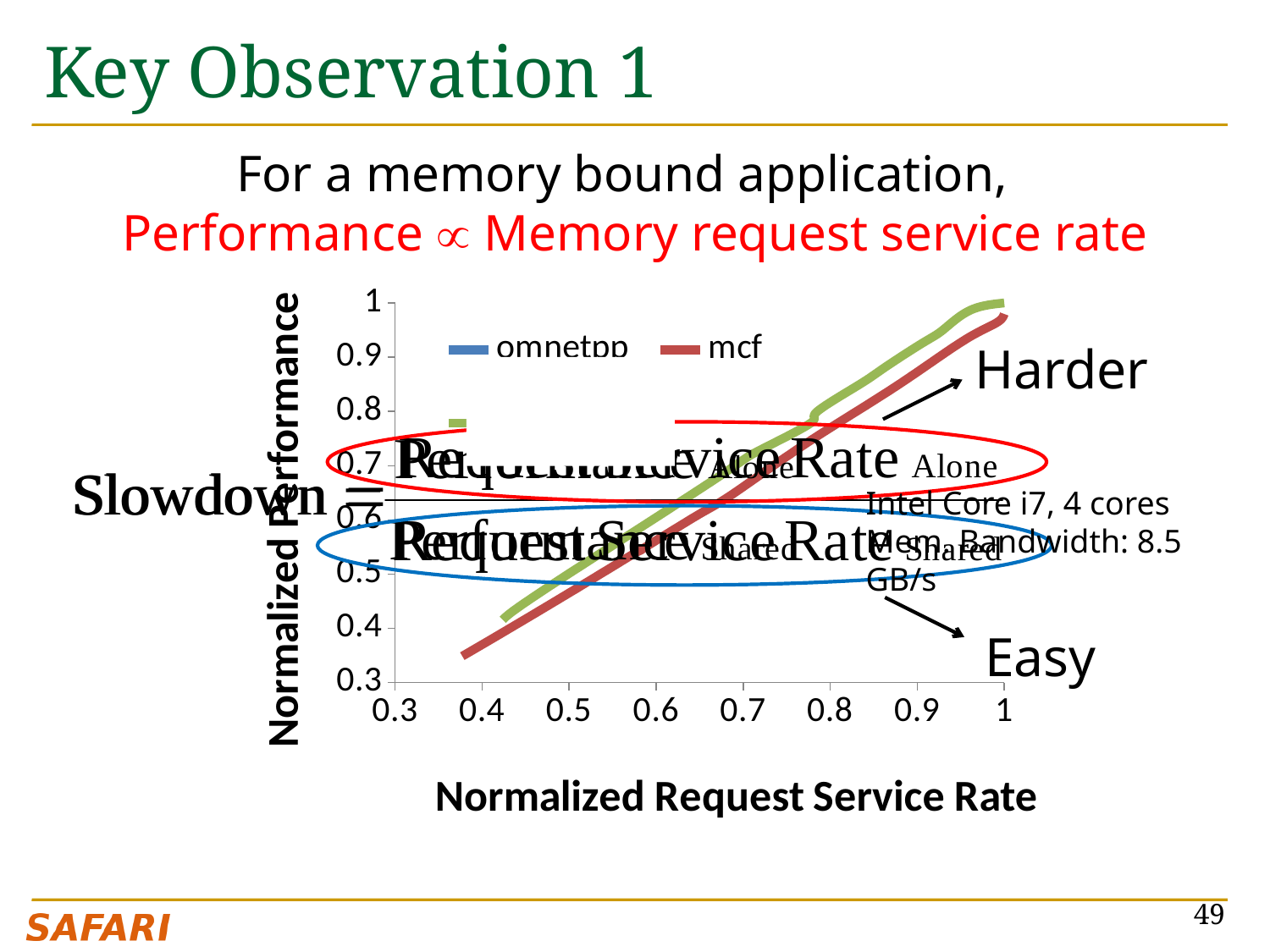
What kind of chart is shown on the slide? line chart What is the title of the chart's x axis? Normalized Request Service Rate What is the lowest value shown on the chart's y axis? 0.3 How many tick labels are shown on the chart's x axis? 8 Which two series are listed in the chart's legend? omnetpp and mcf How many series does the chart's legend list? 2 Is the Normalized Performance of mcf at a Normalized Request Service Rate of 1 greater or less than 0.9? greater Do the plotted values rise or fall as Normalized Request Service Rate increases? rise